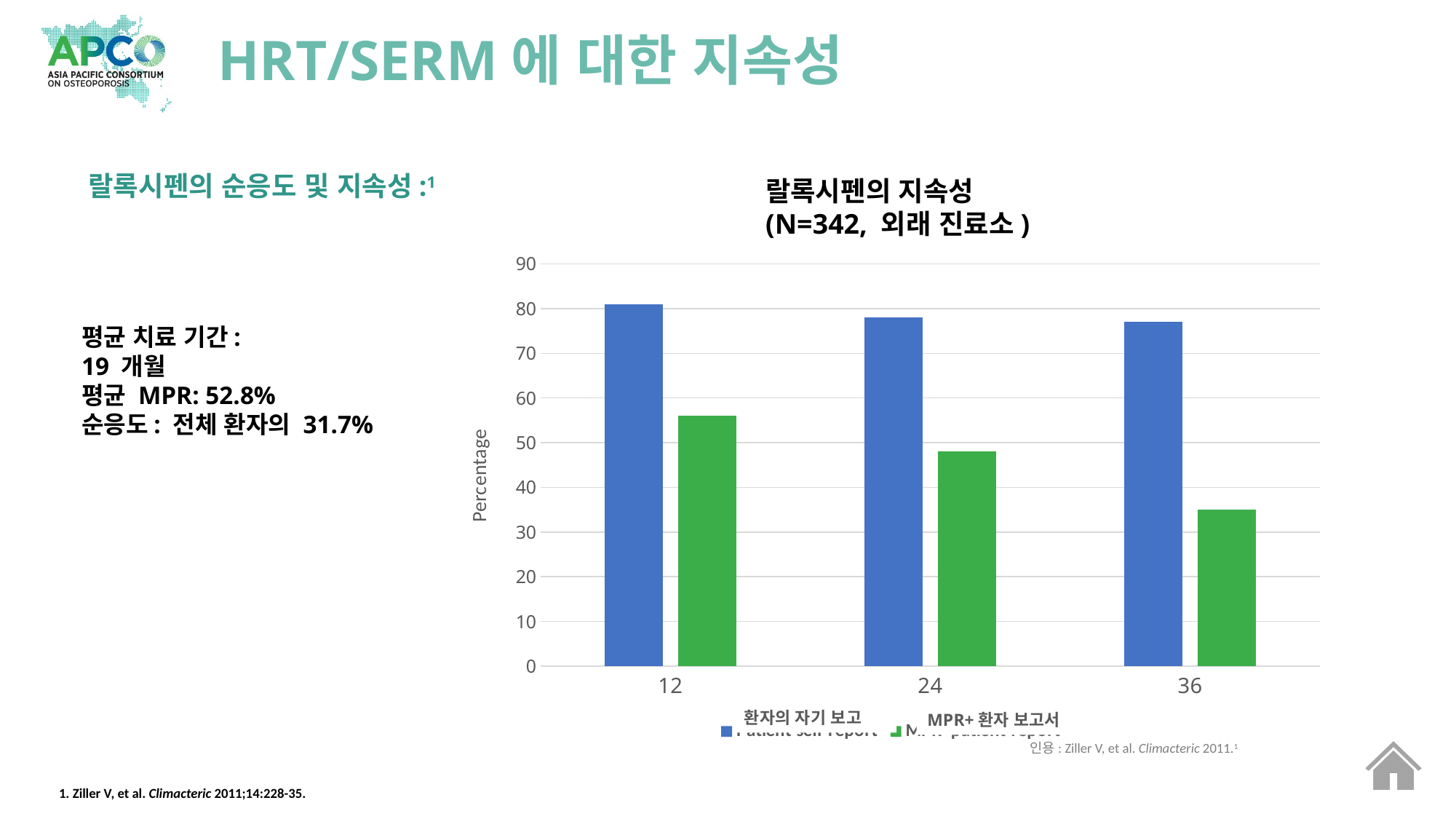
What is the label of the y axis of the chart? Percentage What kind of chart is shown on the slide? bar chart Is the value for 환자의 자기 보고 at 36 greater or less than 70? greater How many series does the chart legend list? 2 At which x-axis category is the MPR+ 환자 보고서 value lowest? 36 At 24, which series has the larger value, 환자의 자기 보고 or MPR+ 환자 보고서? 환자의 자기 보고 Is the value for MPR+ 환자 보고서 at 36 greater or less than 40? less How many categories are shown on the x axis of the chart? 3 Is the value for MPR+ 환자 보고서 at 12 greater or less than 50? greater Do the MPR+ 환자 보고서 values rise or fall from 12 to 36? fall What is the title of the chart? 랄록시펜의 지속성 (N=342, 외래 진료소)